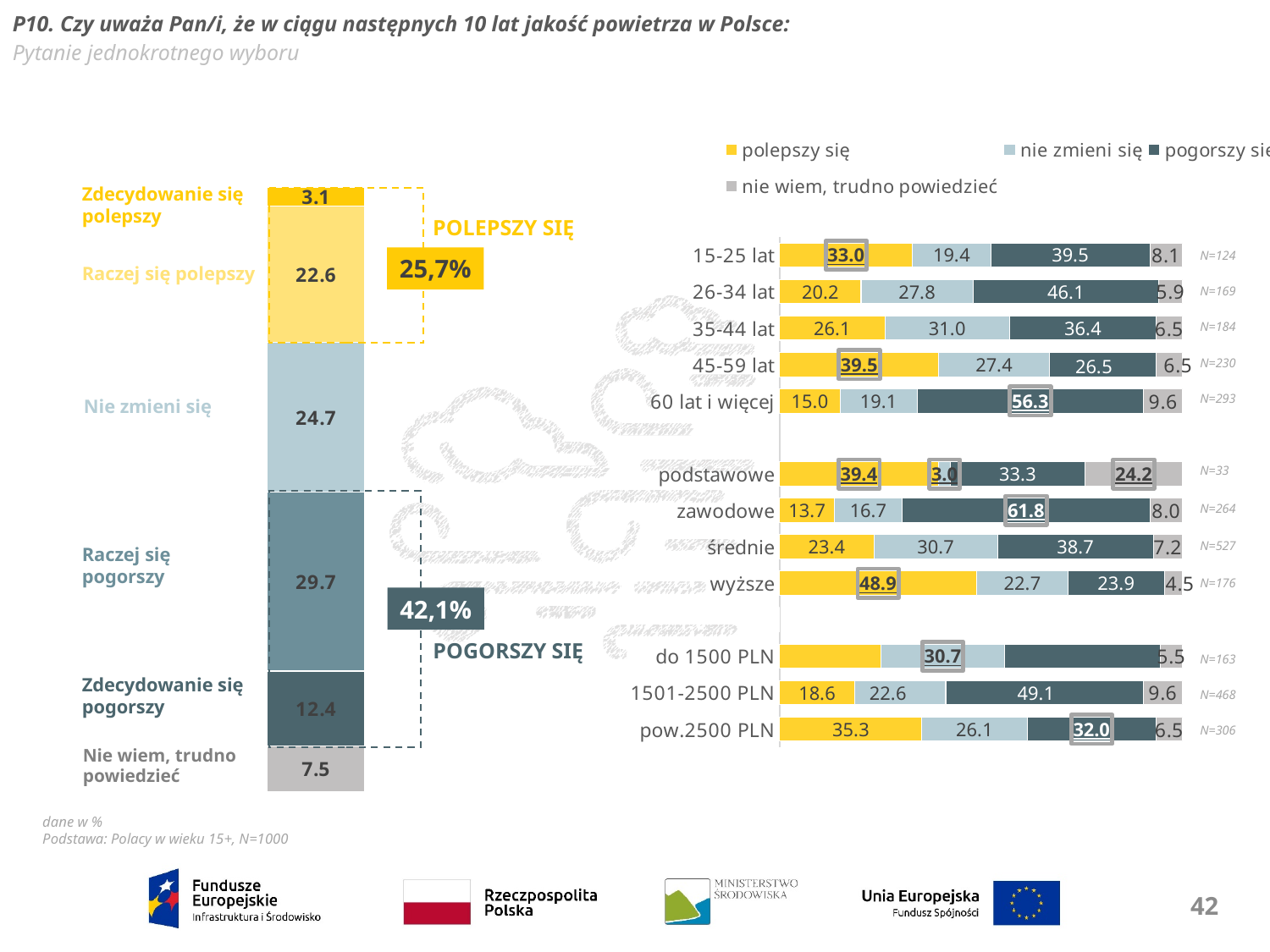
In the right chart by demographic groups, which is larger: the 'polepszy się' value for '15-25 lat' or for '26-34 lat'? 15-25 lat How many demographic groups are shown in the right chart? 12 In the right chart by demographic groups, what is the 'polepszy się' value for 'wyższe'? 48.9 In the left stacked bar chart, what is the difference between 'Raczej się pogorszy' and 'Zdecydowanie się pogorszy'? 17.3 In the left stacked bar chart, what is the value for 'Raczej się pogorszy'? 29.7 How many series does the legend of the right chart list? 4 In the left stacked bar chart, which category has the lowest value? Zdecydowanie się polepszy In the right chart by demographic groups, which group has the highest 'pogorszy się' value? zawodowe In the right chart by demographic groups, what is the 'pogorszy się' value for '60 lat i więcej'? 56.3 In the right chart by demographic groups, what is the 'nie wiem, trudno powiedzieć' value for 'podstawowe'? 24.2 In the left stacked bar chart, what is the value for 'Nie wiem, trudno powiedzieć'? 7.5 What type of chart is the right chart by demographic groups? Stacked bar chart